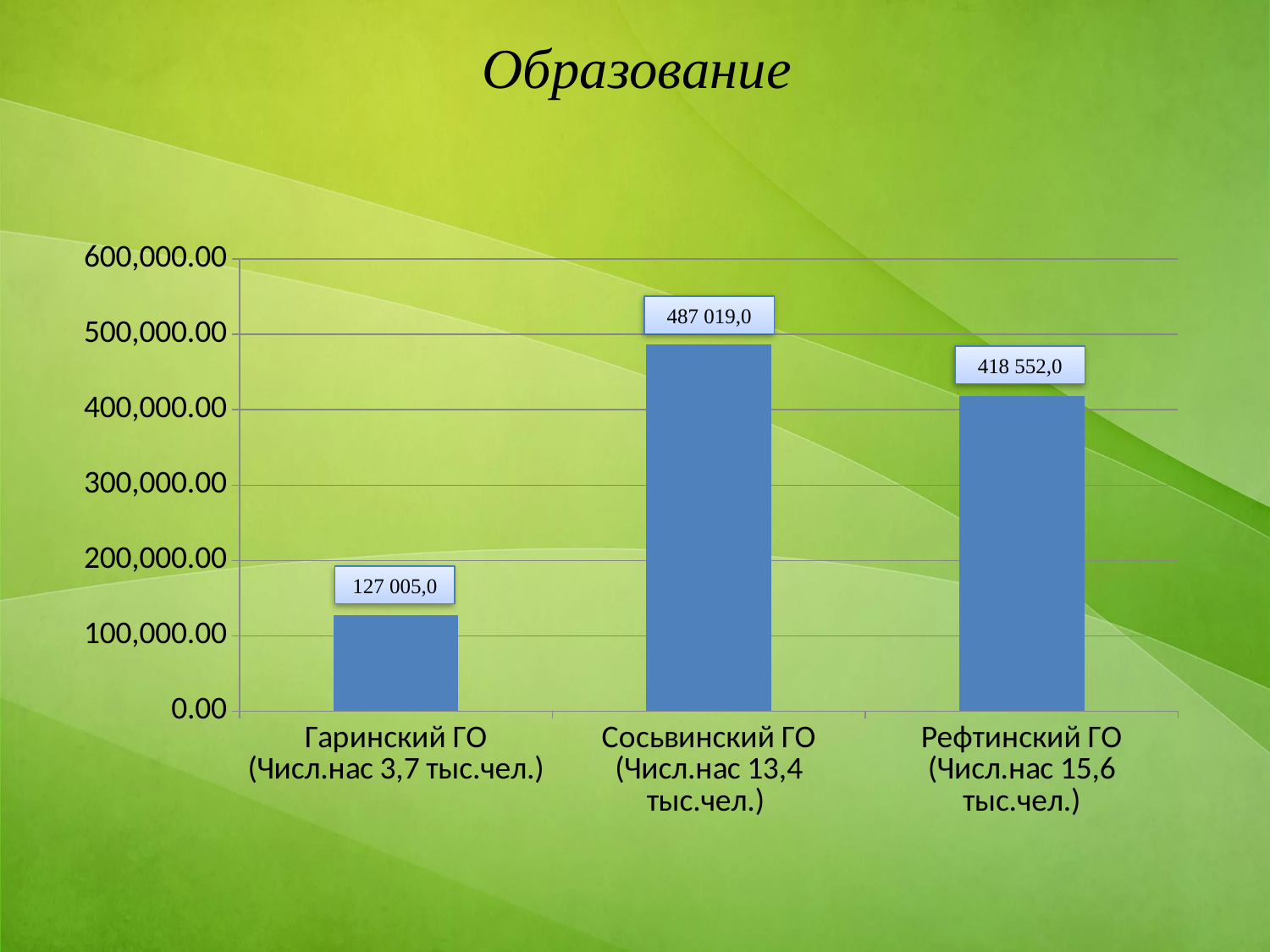
What is the title of the slide? Образование How many categories are shown on the chart? 3 What is the value for Сосьвинский ГО? 487 019,0 What kind of chart is shown on the slide? bar chart Which is larger, the value for Рефтинский ГО or the value for Гаринский ГО? Рефтинский ГО What is the difference between the values for Сосьвинский ГО and Рефтинский ГО? 68 467,0 Which category has the highest value? Сосьвинский ГО Which category has the lowest value? Гаринский ГО What is the value for Рефтинский ГО? 418 552,0 What is the difference between the values for Сосьвинский ГО and Гаринский ГО? 360 014,0 Is the value for Рефтинский ГО greater or less than 400,000.00? greater What is the value for Гаринский ГО? 127 005,0